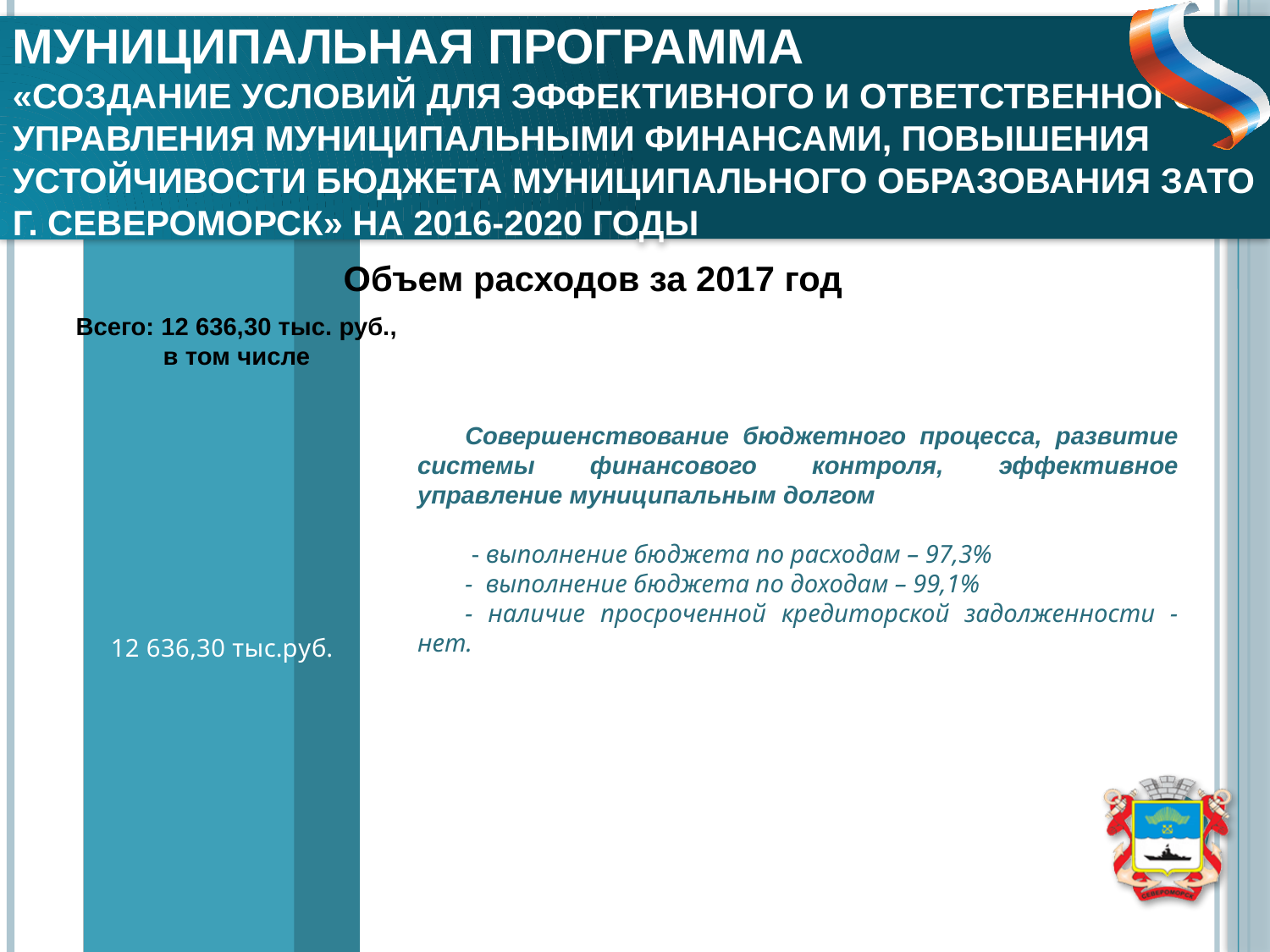
How many bars are plotted in the chart "Объем расходов за 2017 год"? 1 What value is printed on the bar in the chart titled "Объем расходов за 2017 год"? 12 636,30 тыс.руб. What colour is the bar in the chart "Объем расходов за 2017 год"? teal (blue-green) What kind of chart is shown under the heading "Объем расходов за 2017 год"? bar chart What is the title of the chart on the slide? Объем расходов за 2017 год What total amount ("Всего") is stated above the chart? 12 636,30 тыс. руб.